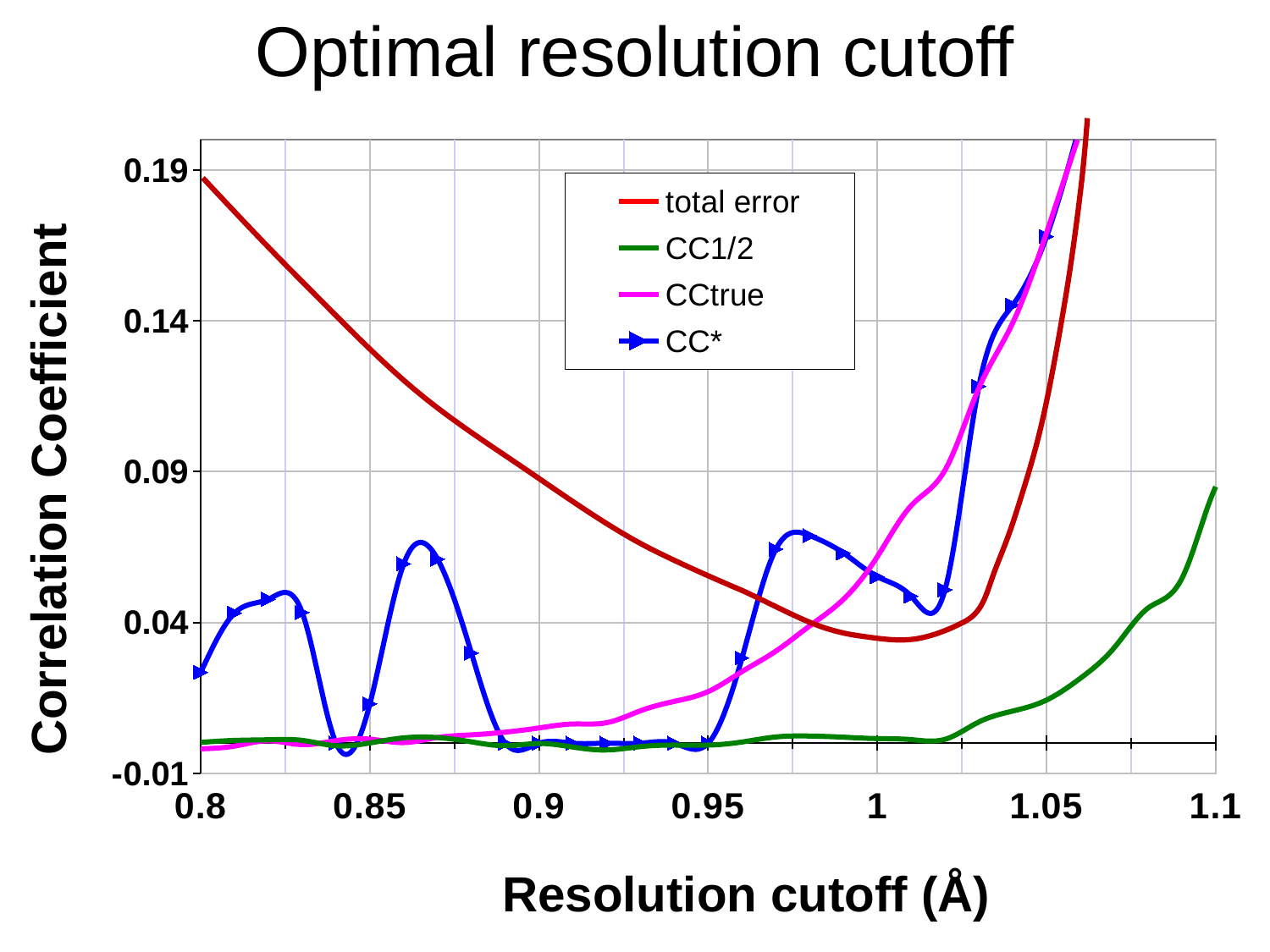
Is the value of the CC* series at a resolution cutoff of 0.85 greater or less than 0.04? less How many series does the legend list? 4 At a resolution cutoff of 1.05, which series has the larger value, total error or CCtrue? CCtrue What kind of chart is shown on the slide? line chart Is the value of the total error series at a resolution cutoff of 0.8 greater or less than 0.14? greater At a resolution cutoff of 0.9, which series has the larger value, total error or CC1/2? total error Is the value of the CCtrue series at a resolution cutoff of 1.05 greater or less than 0.14? greater Does the total error series rise or fall as the resolution cutoff increases from 0.8 to 1.0? fall Which series has the highest value at a resolution cutoff of 0.8? total error What is the title of the chart? Optimal resolution cutoff What is the label of the x axis? Resolution cutoff (Å)